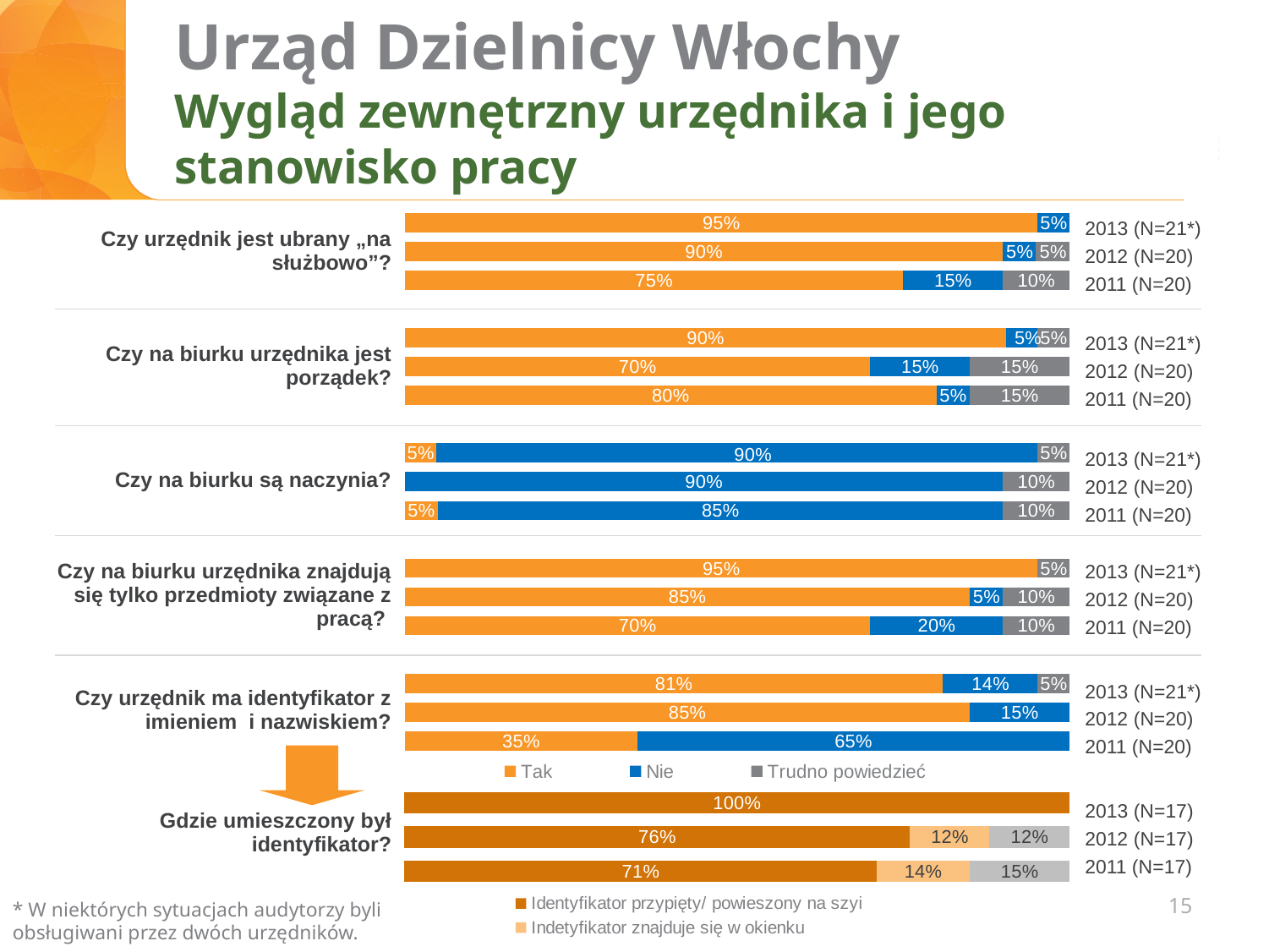
What type of chart is used on this slide? Stacked bar chart In the upper chart, for "Czy na biurku są naczynia?", is the "Nie" share larger in 2013 or in 2011? 2013 In the upper chart, how many series does the legend list? 3 In the upper chart, what percentage answered "Tak" to "Czy urzędnik jest ubrany „na służbowo”?" in 2013? 95% In the lower chart "Gdzie umieszczony był identyfikator?", what percentage had the badge pinned or hung around the neck in 2013? 100% In the upper chart, what percentage answered "Trudno powiedzieć" to "Czy na biurku urzędnika jest porządek?" in 2012? 15% In the upper chart, for "Czy na biurku urzędnika znajdują się tylko przedmioty związane z pracą?", what is the difference between the "Tak" share in 2013 and in 2011? 25% In the lower chart "Gdzie umieszczony był identyfikator?", what is the difference between the "przypięty/ powieszony na szyi" share in 2012 and in 2011? 5% In the upper chart, how does the "Tak" share for "Czy urzędnik ma identyfikator z imieniem i nazwiskiem?" change from 2011 to 2013? It rises (35% to 81%) In the upper chart, for "Czy urzędnik jest ubrany „na służbowo”?", which year has the lowest "Tak" share? 2011 In the upper chart, what percentage answered "Nie" to "Czy urzędnik ma identyfikator z imieniem i nazwiskiem?" in 2011? 65% In the lower chart "Gdzie umieszczony był identyfikator?", what percentage had the badge in the window ("w okienku") in 2011? 14%